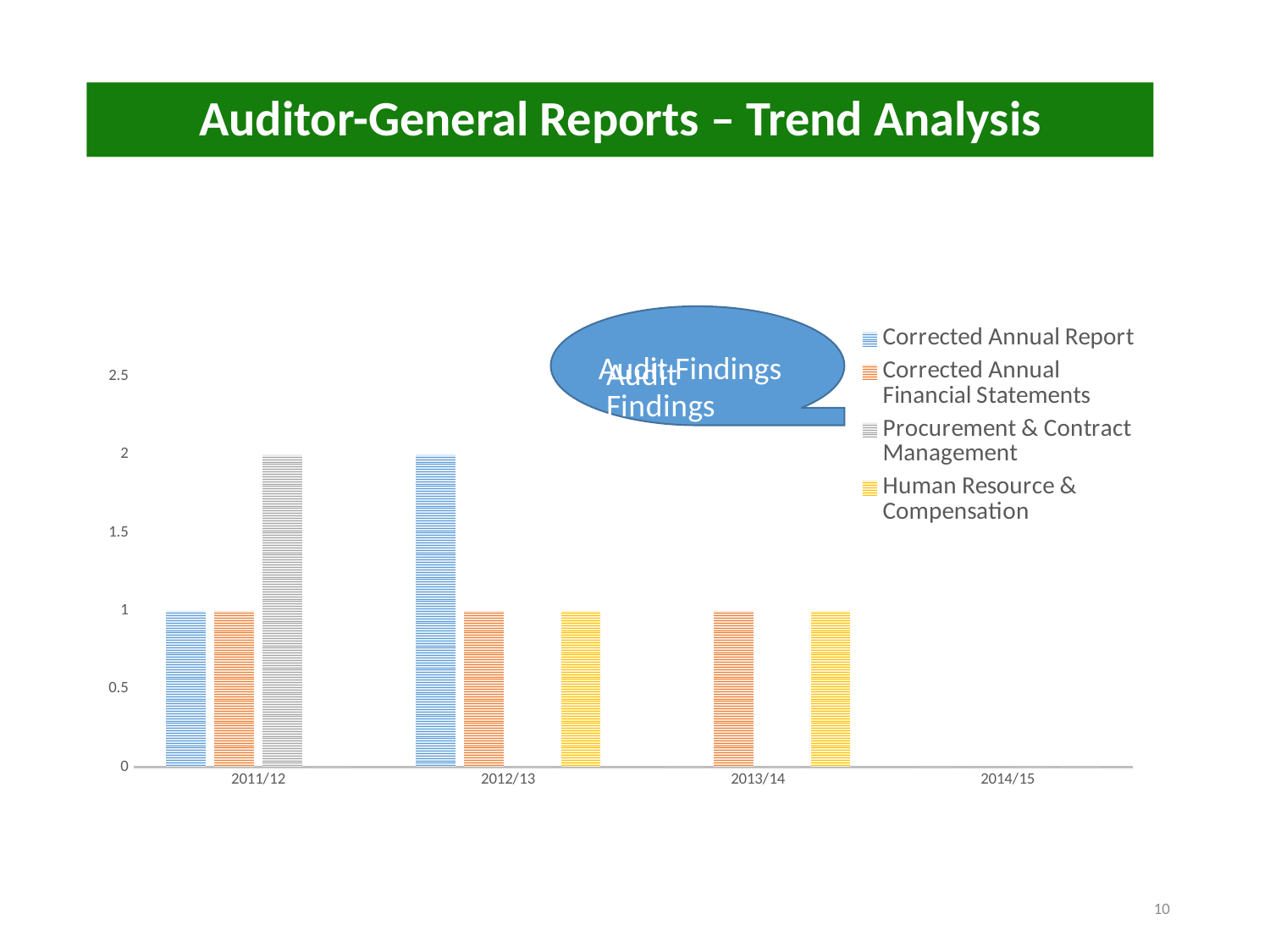
What is the value for Procurement & Contract Management in 2011/12? 2 How many year categories are shown on the x axis? 4 How many series does the legend list? 4 Is the value for Corrected Annual Report in 2012/13 larger or smaller than the value for Corrected Annual Financial Statements in 2012/13? larger What is the value for Human Resource & Compensation in 2013/14? 1 Which series has the highest value in 2012/13? Corrected Annual Report What kind of chart is shown on the slide? bar chart What is the label in the callout shape above the chart? Audit Findings What is the difference between the Procurement & Contract Management value in 2011/12 and the Corrected Annual Report value in 2011/12? 1 Is the value for Corrected Annual Report in 2012/13 greater or less than 1.5? greater Which series has the highest value in 2011/12? Procurement & Contract Management What is the value for Corrected Annual Report in 2012/13? 2